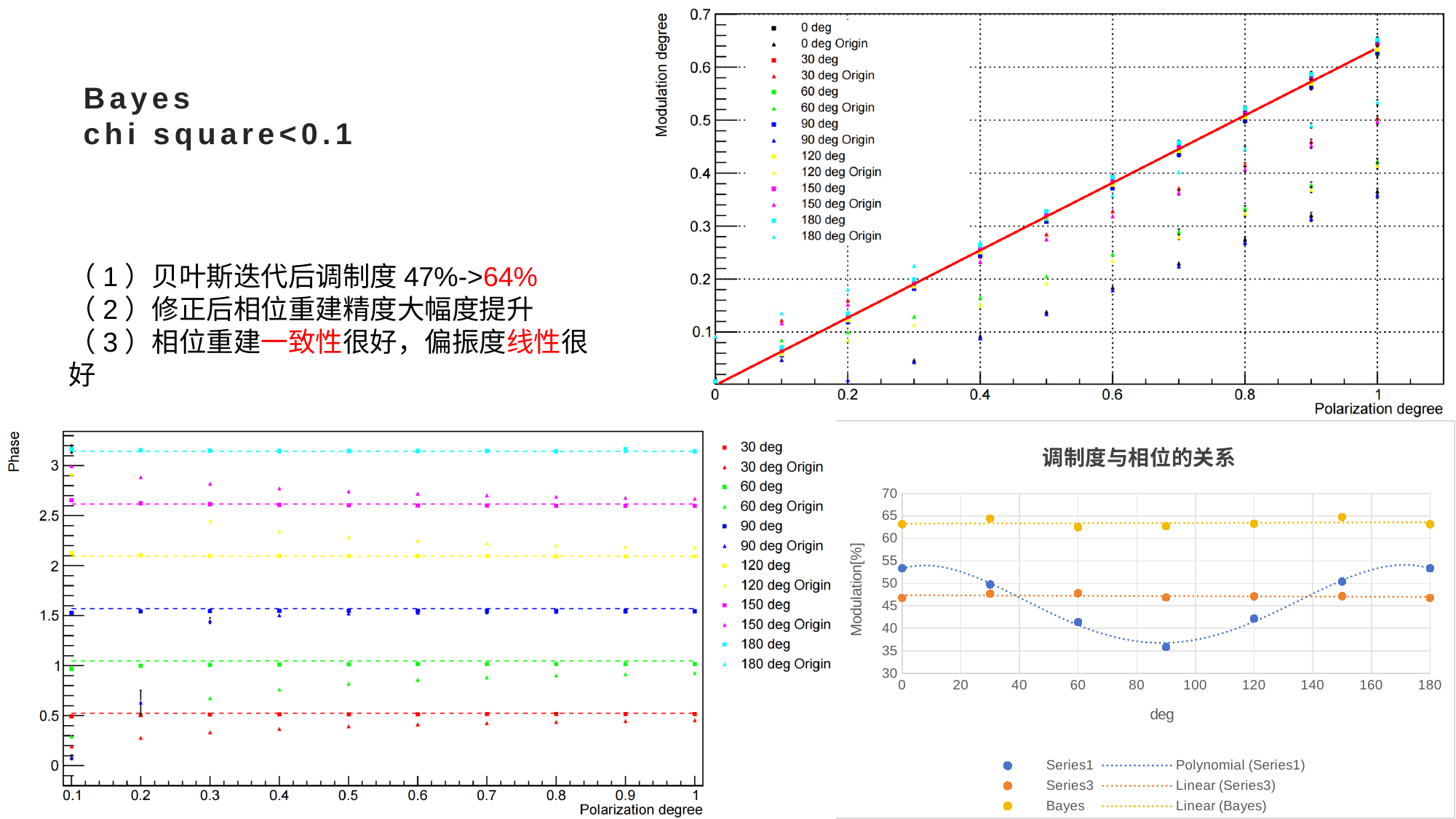
In the bottom-right chart '调制度与相位的关系', how many data points does Series1 have? 7 In the bottom-right chart '调制度与相位的关系', at which deg value is Series1 lowest? 90 In the bottom-right chart '调制度与相位的关系', is the Series1 value at 90 deg greater or less than 40? less In the bottom-left chart, is the 180 deg phase value at polarization degree 0.5 greater or less than 3? greater In the bottom-right chart '调制度与相位的关系', how many entries does the legend list? 6 In the top-right chart, how many entries does the legend list? 14 In the top-right chart, does the modulation degree rise or fall as the polarization degree increases? rise In the top-right chart, is the 180 deg value at polarization degree 1 greater or less than 0.6? greater What is the title of the bottom-right chart? 调制度与相位的关系 In the bottom-right chart '调制度与相位的关系', at 60 deg, which is larger: Bayes or Series1? Bayes In the bottom-right chart '调制度与相位的关系', what is the y-axis label? Modulation[%]